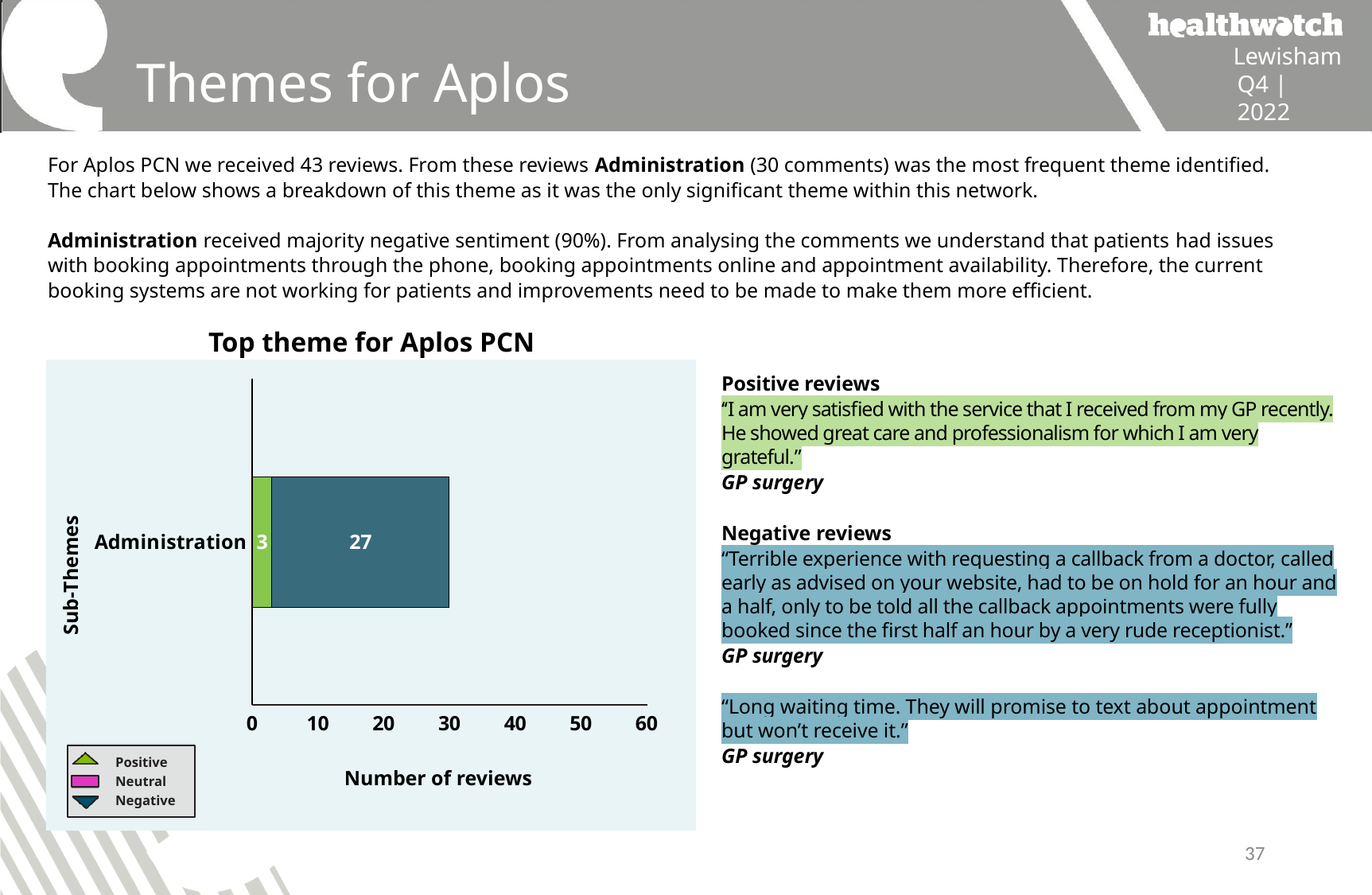
What is the Positive value for Administration? 3 Which series has the smallest value for Administration among those shown in the bar? Positive How many sub-theme categories are plotted on the chart? 1 Is the total length of the Administration bar greater or less than 40? less What is the total number of reviews shown in the Administration bar? 30 What is the difference between the Negative and Positive values for Administration? 24 How many series does the legend list? 3 What is the Negative value for Administration? 27 Which is larger for Administration, the Positive or the Negative value? Negative What is the label of the x axis? Number of reviews What is the title of the chart? Top theme for Aplos PCN What kind of chart is shown on the slide? Stacked bar chart